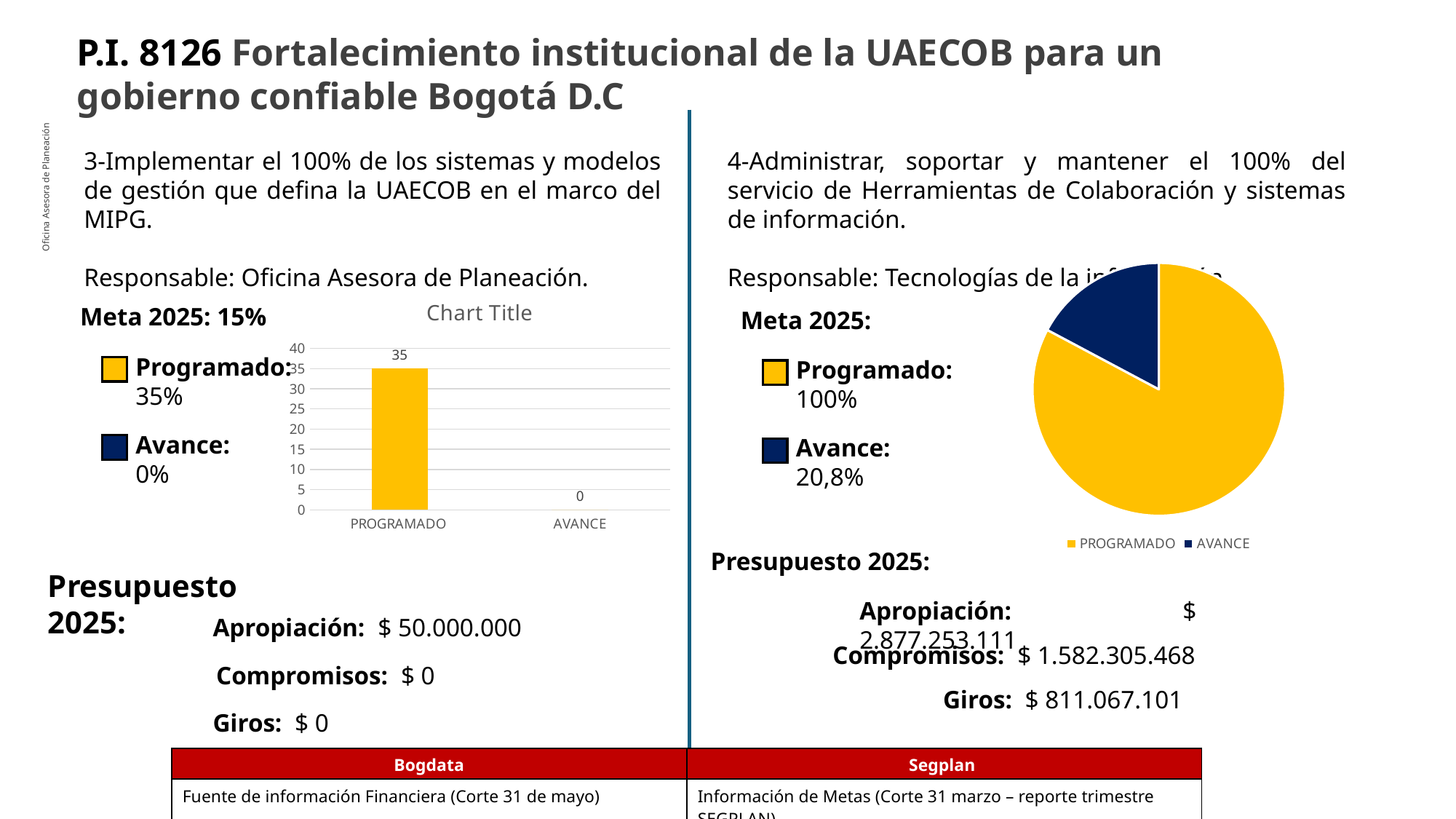
On the bar chart on the left, is the value for PROGRAMADO greater or less than 30? greater On the bar chart on the left, which category has the lowest value? AVANCE On the bar chart on the left, what is the value for PROGRAMADO? 35 How many entries does the legend of the pie chart on the right list? 2 On the bar chart on the left, which category has the highest value? PROGRAMADO On the bar chart on the left, what is the value for AVANCE? 0 How many categories are shown on the bar chart on the left? 2 What kind of chart is the chart on the left side of the slide? bar chart What kind of chart is the chart on the right side of the slide? pie chart What is the title shown above the bar chart on the left? Chart Title On the bar chart on the left, what is the difference between the PROGRAMADO and AVANCE values? 35 On the pie chart on the right, which slice is larger, PROGRAMADO or AVANCE? PROGRAMADO